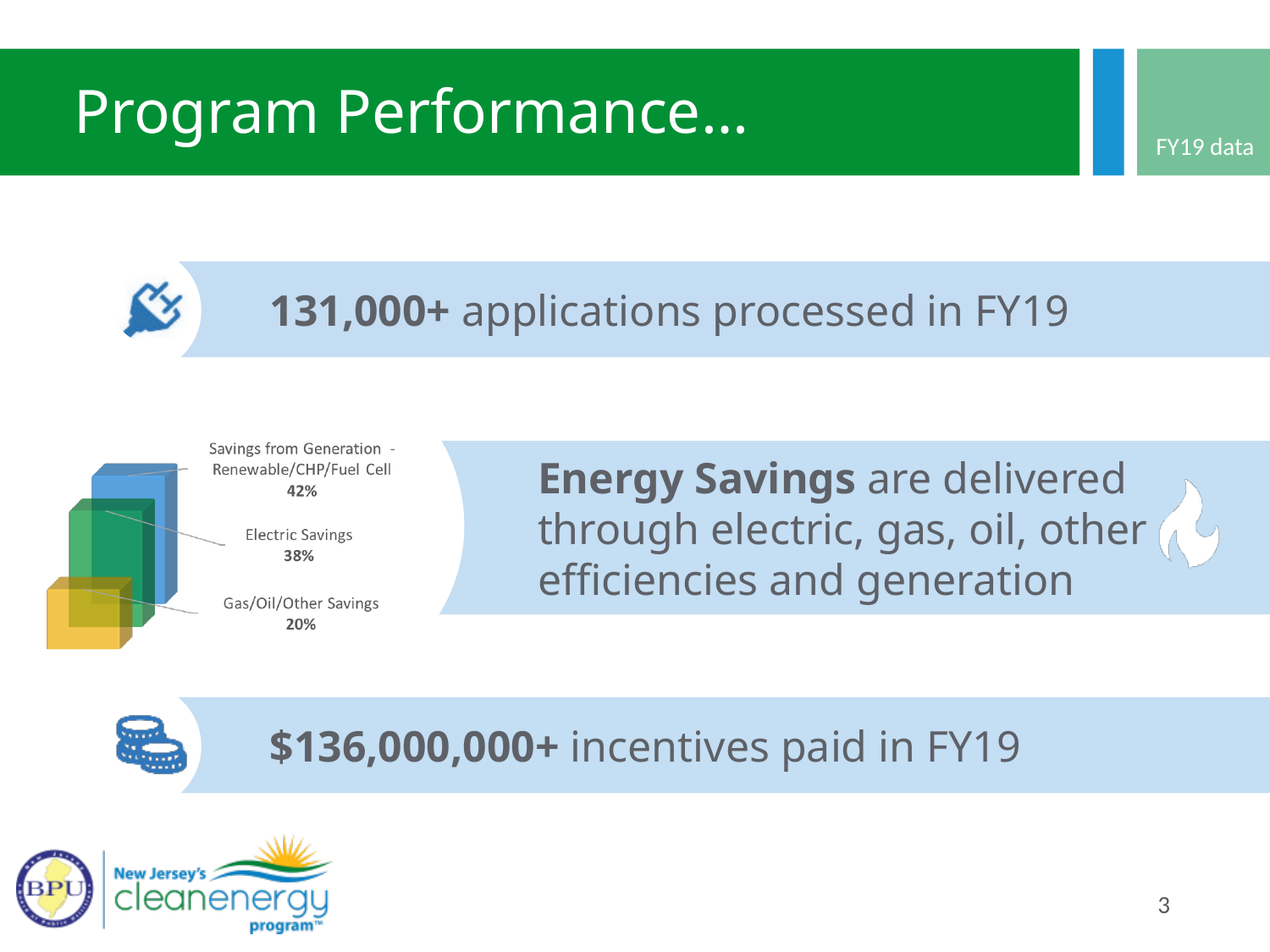
What percentage of energy savings comes from Electric Savings? 38% What do the three percentages in the energy savings chart add up to? 100% What percentage of energy savings comes from Savings from Generation - Renewable/CHP/Fuel Cell? 42% Which savings category has the smallest share in the energy savings chart? Gas/Oil/Other Savings What percentage of energy savings comes from Gas/Oil/Other Savings? 20% What is the difference in percentage points between Electric Savings and Gas/Oil/Other Savings? 18 What colour is the block representing Gas/Oil/Other Savings? yellow What is the difference in percentage points between Savings from Generation - Renewable/CHP/Fuel Cell and Electric Savings? 4 What kind of chart is used to show the energy savings breakdown? bar chart Which is larger, Electric Savings or Gas/Oil/Other Savings? Electric Savings How many savings categories are shown in the energy savings chart? 3 Which savings category has the largest share in the energy savings chart? Savings from Generation - Renewable/CHP/Fuel Cell